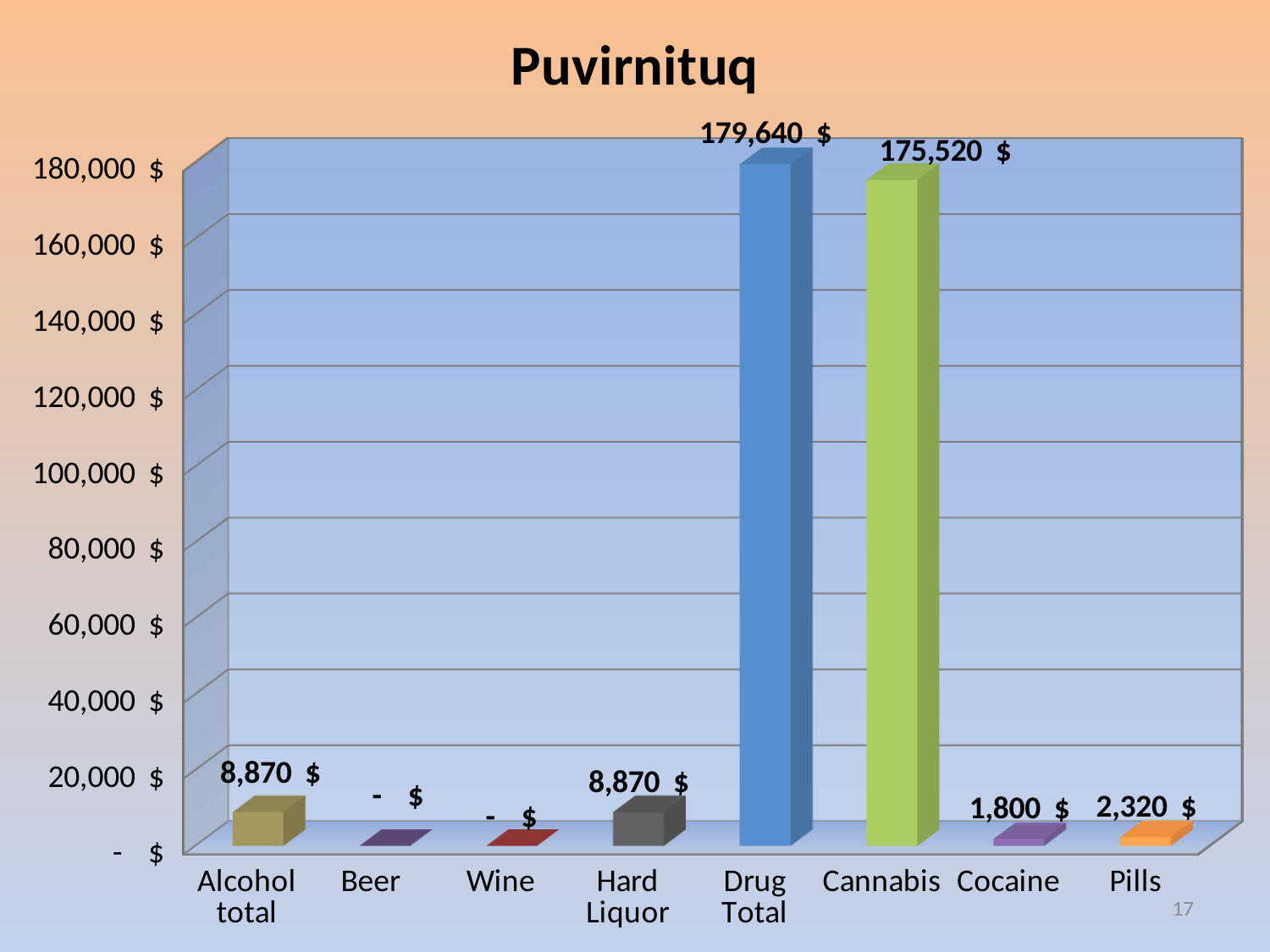
What is the difference between Drug Total and Cannabis? 4,120 $ What kind of chart is this? Bar chart What is the title of the chart? Puvirnituq How many categories are shown on the x axis? 8 What is the difference between Pills and Cocaine? 520 $ What is the value for Drug Total? 179,640 $ Which category has the highest value? Drug Total What is the value for Alcohol total? 8,870 $ What is the value for Pills? 2,320 $ What is the value for Cannabis? 175,520 $ What is the value for Cocaine? 1,800 $ Which is larger, Alcohol total or Pills? Alcohol total